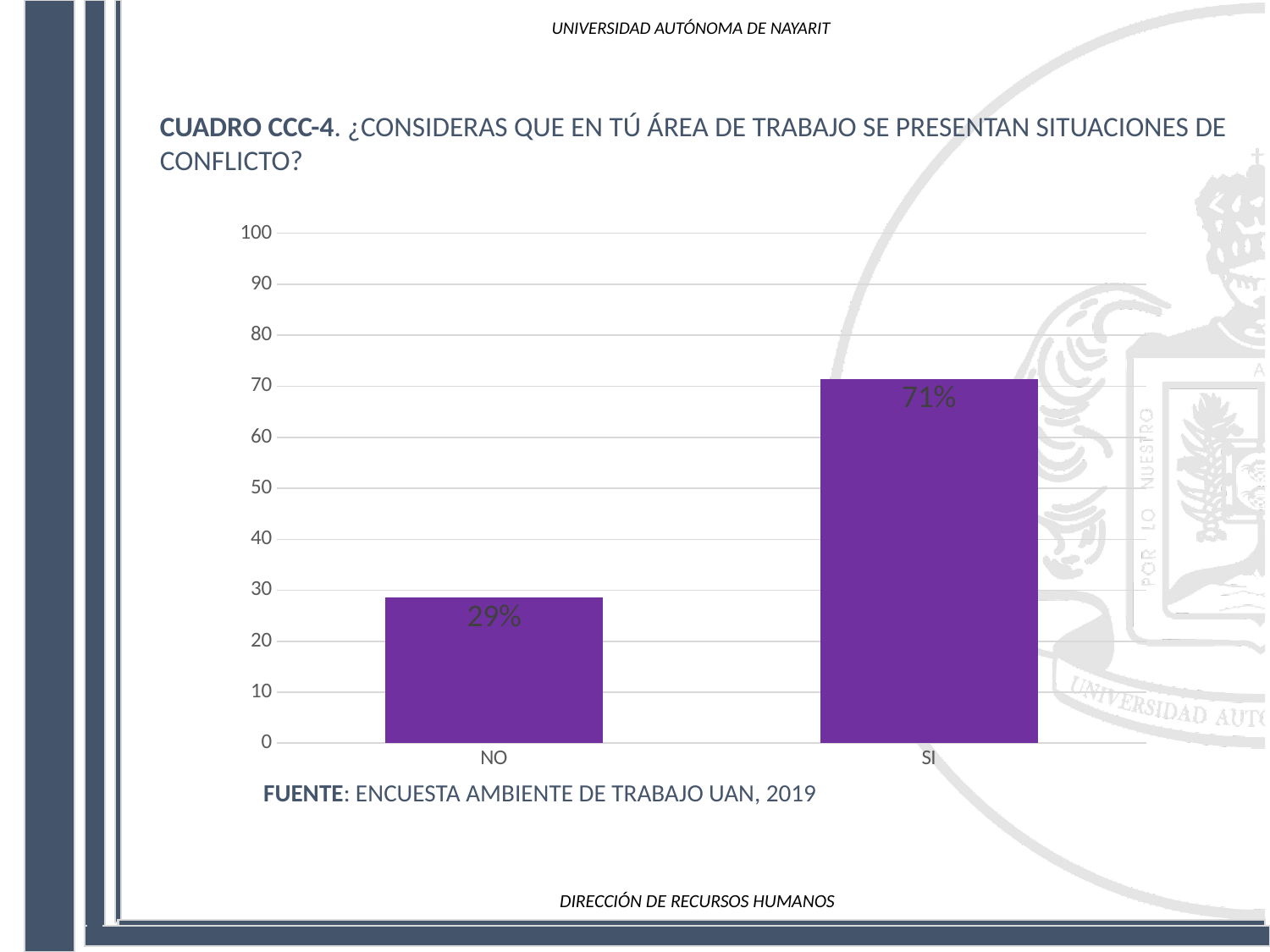
Which category has the lowest value? NO Which category has the highest value? SI Is the value for SI greater or less than 60? greater What kind of chart is shown on the slide? bar chart What is the source cited below the chart? ENCUESTA AMBIENTE DE TRABAJO UAN, 2019 What is the value for SI? 71% Which is larger, the value for NO or the value for SI? SI What is the value for NO? 29% How many categories are shown on the x axis? 2 Is the value for NO greater or less than 40? less What is the difference between the values for SI and NO? 42% What colour are the bars in the chart? purple